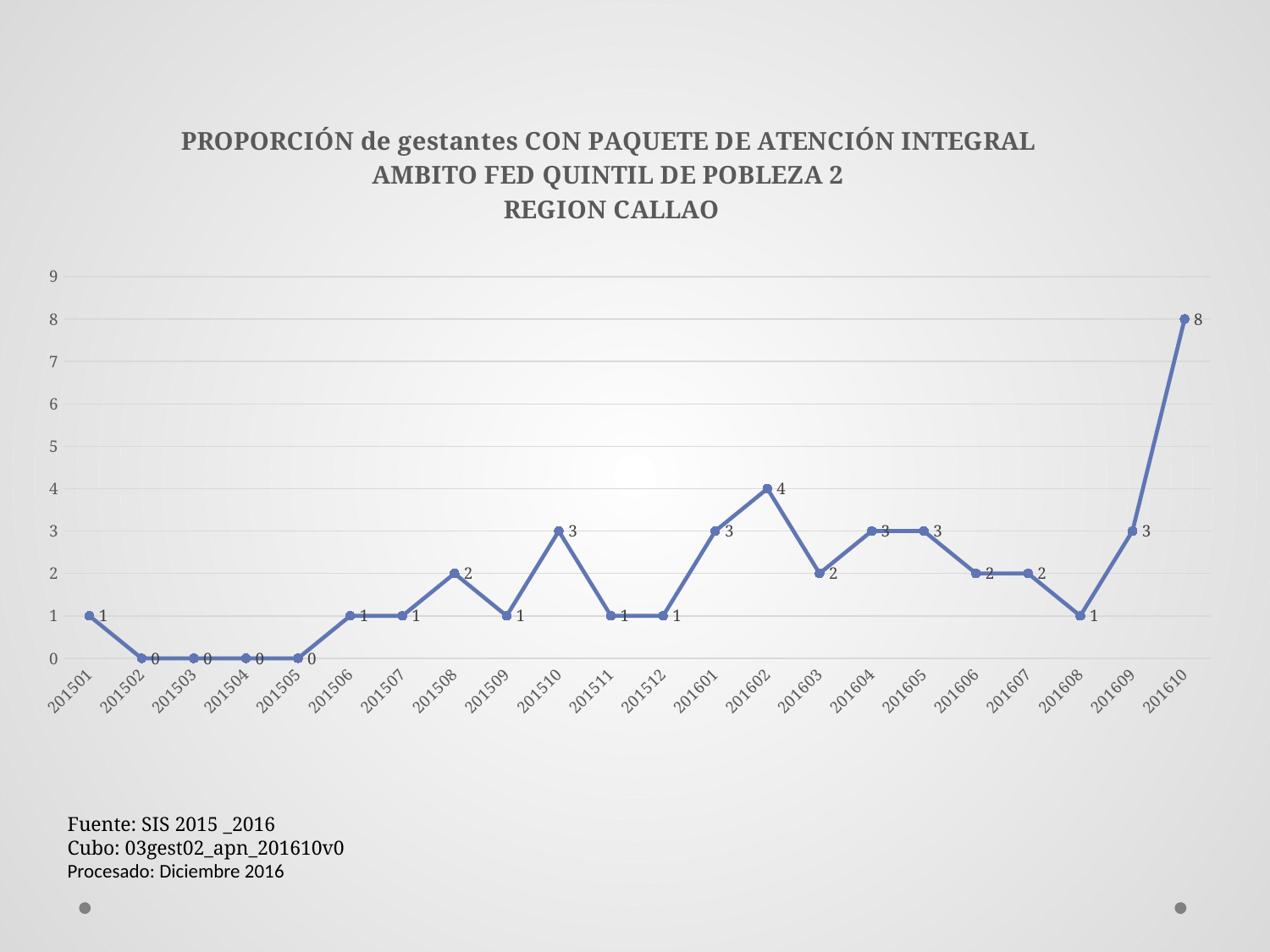
What kind of chart is shown? line chart Is the value for 201610 greater or less than 5? greater How many periods are plotted on the x axis? 22 What is the difference between the values for 201610 and 201609? 5 What is the value for 201610? 8 What is the difference between the values for 201602 and 201603? 2 What is the value for 201603? 2 Which region does the chart title refer to? REGION CALLAO Which period has the highest value? 201610 What is the value for 201508? 2 What is the value for 201602? 4 Which is larger, the value for 201510 or the value for 201511? 201510